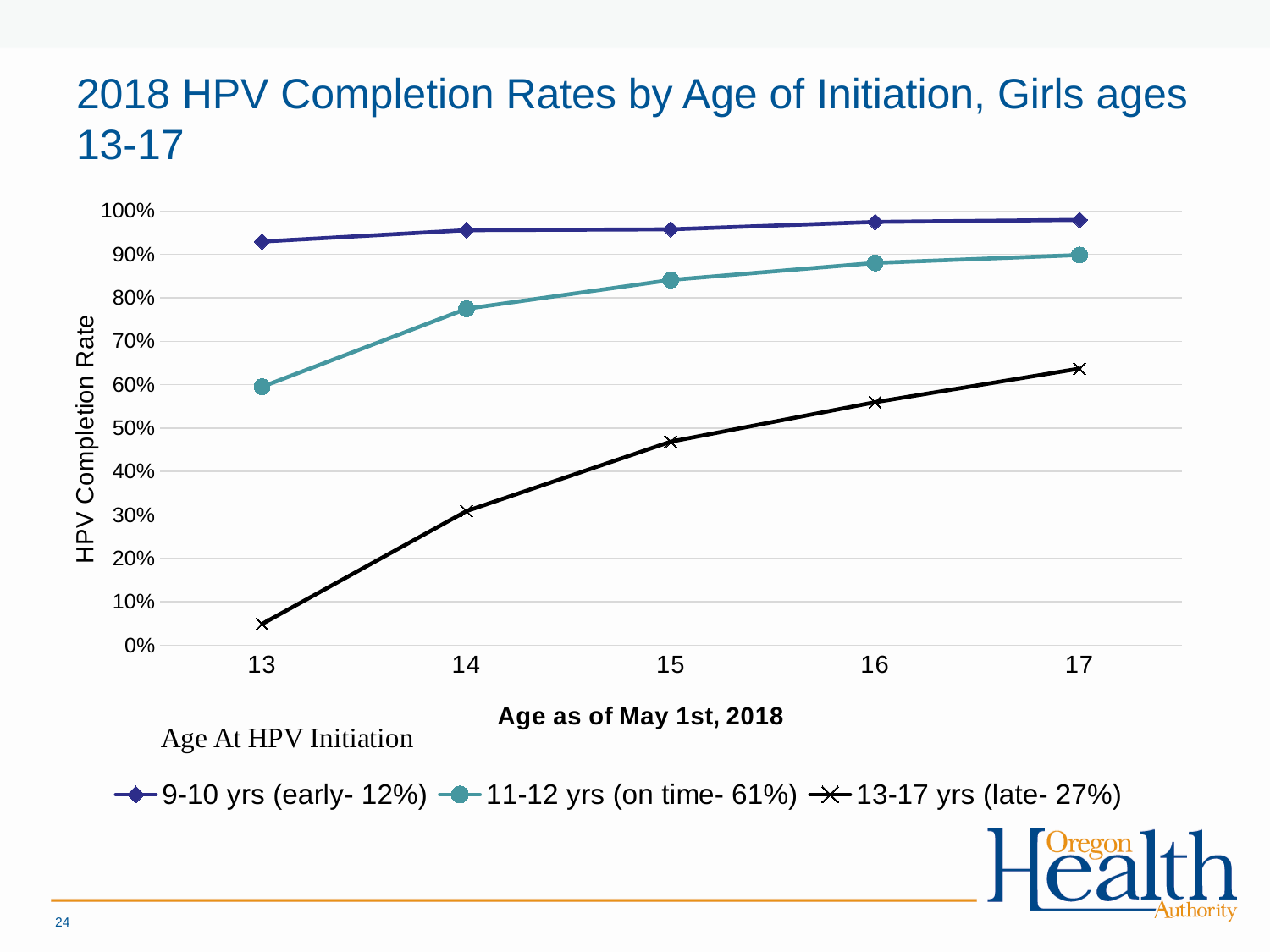
Which series has the highest completion rate at age 17? 9-10 yrs (early- 12%) How many series does the legend list? 3 Is the value for the 13-17 yrs (late- 27%) series at age 15 greater or less than 50%? less What kind of chart is shown on the slide? Line chart Is the value for the 13-17 yrs (late- 27%) series at age 13 greater or less than 10%? less Do the values for the 13-17 yrs (late- 27%) series rise or fall as age increases from 13 to 17? Rise What is the title of the x axis? Age as of May 1st, 2018 Is the value for the 11-12 yrs (on time- 61%) series at age 13 greater or less than 70%? less How many age categories are shown on the x axis? 5 At age 13, which series has the larger value: 9-10 yrs (early- 12%) or 13-17 yrs (late- 27%)? 9-10 yrs (early- 12%)